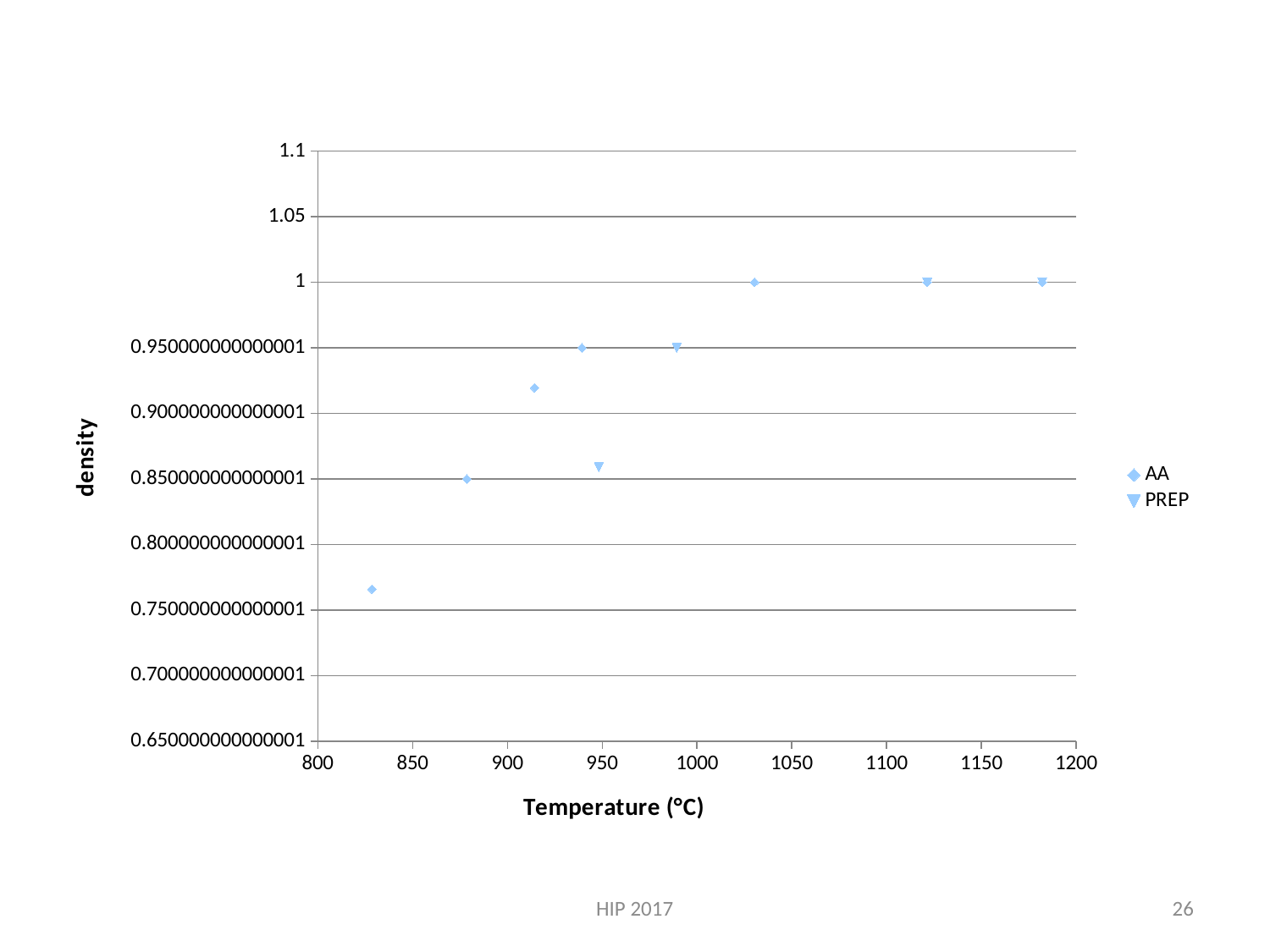
How many series does the legend list? 2 What are the two series named in the legend? AA and PREP What is the title of the x axis? Temperature (°C) How many PREP data points are plotted? 4 Which series contains the point with the lowest density on the chart? AA How many AA data points are plotted? 7 Which has the higher density: the AA point near 940°C or the PREP point near 950°C? AA point near 940°C Is the density of the lowest-temperature AA point (near 830°C) greater or less than 0.8? less Is the density of the AA point near 1030°C greater or less than 0.95? greater Does density rise or fall as temperature increases along the x axis? rise Is the density of the lowest-temperature PREP point (near 950°C) greater or less than 0.9? less What kind of chart is shown on the slide? scatter chart